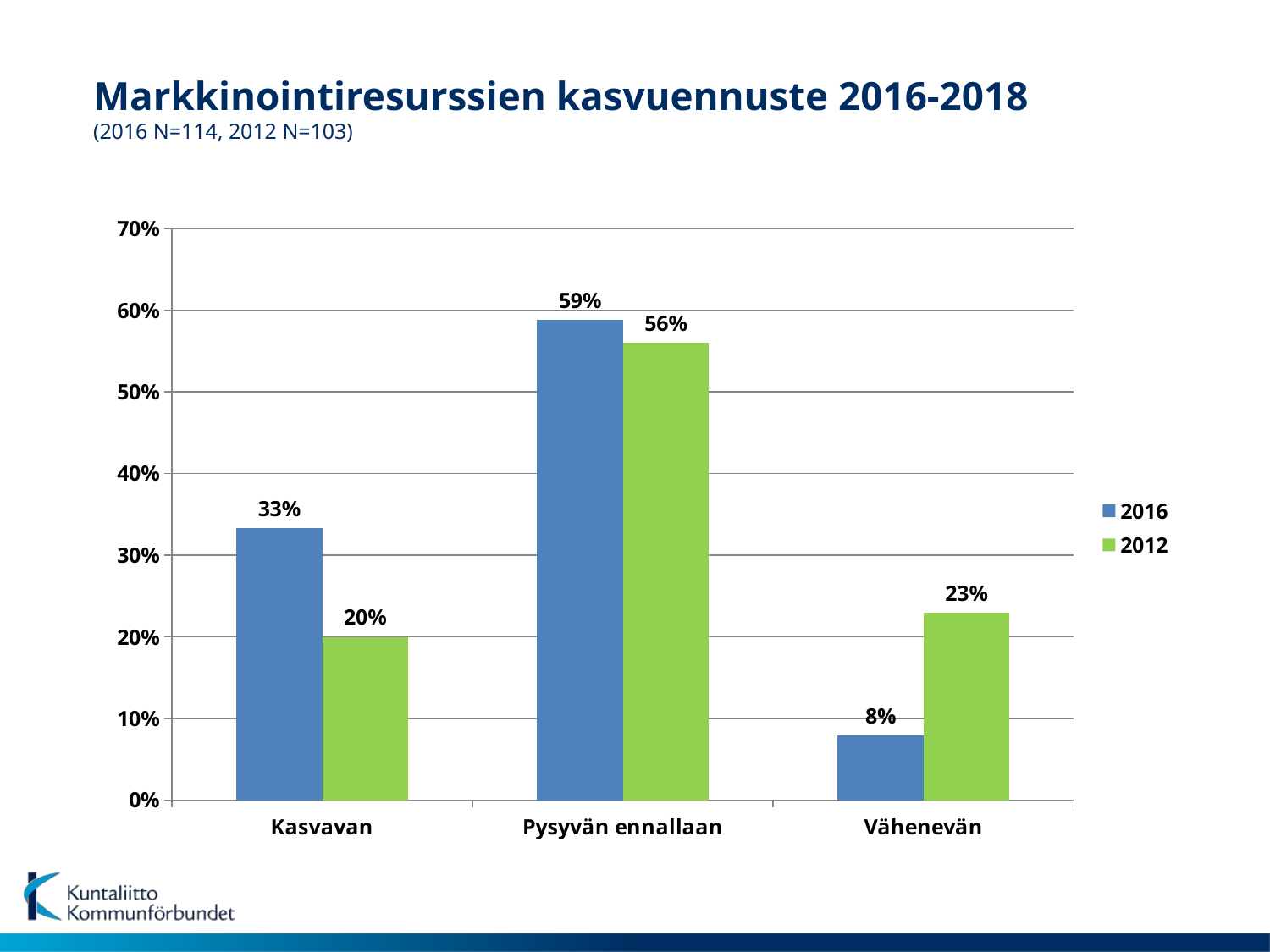
What is the difference between the 2012 and 2016 values for Vähenevän? 15% Which category has the lowest value in the 2012 series? Kasvavan How many series does the legend list? 2 What is the value for Pysyvän ennallaan in the 2012 series? 56% What is the title of the chart? Markkinointiresurssien kasvuennuste 2016-2018 Which is larger for Pysyvän ennallaan, the 2016 value or the 2012 value? 2016 What is the value for Kasvavan in the 2016 series? 33% What kind of chart is shown on the slide? Bar chart How many categories are shown on the x axis? 3 Which category has the highest value in the 2016 series? Pysyvän ennallaan What is the difference between the 2016 and 2012 values for Kasvavan? 13% What is the value for Vähenevän in the 2012 series? 23%